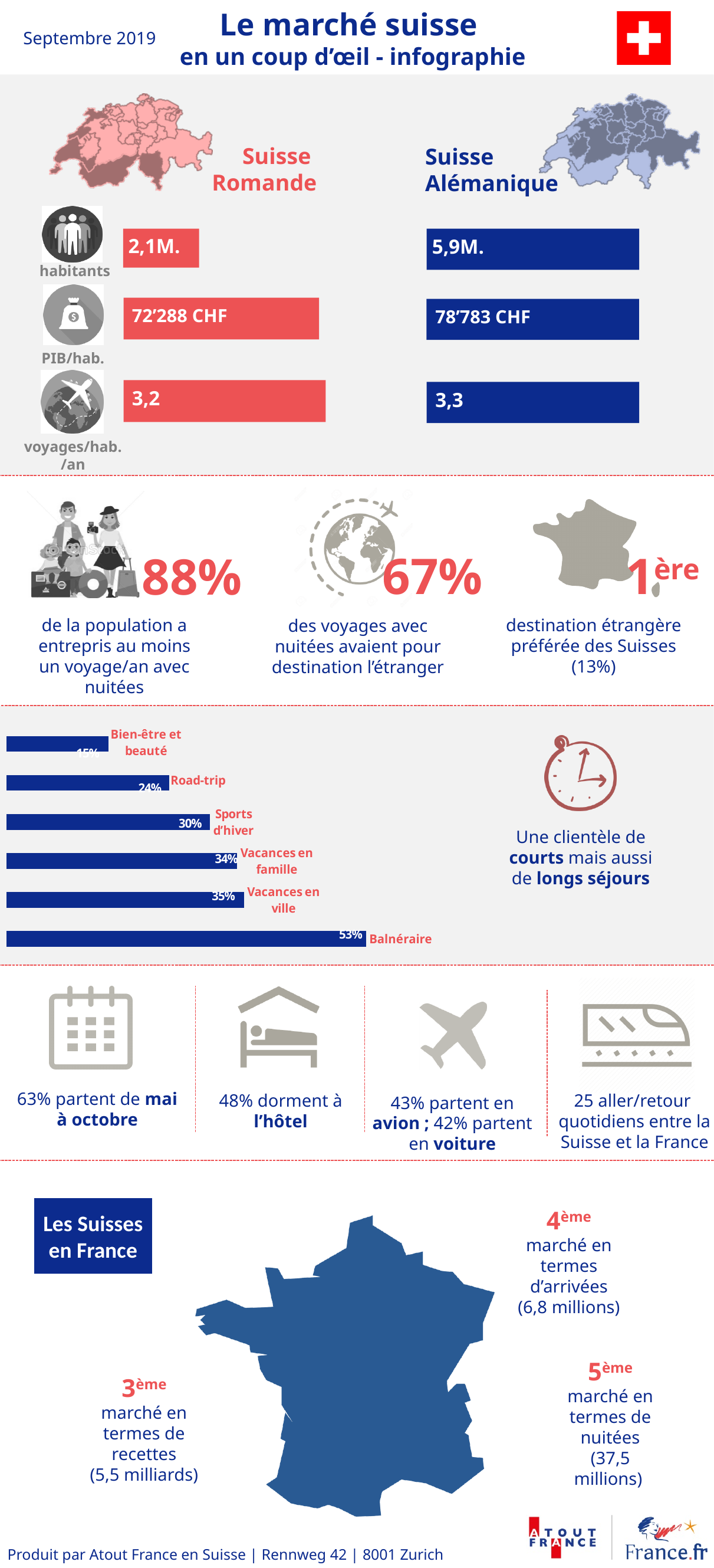
What kind of chart is used to show the holiday types (Bien-être et beauté, Road-trip, etc.)? bar chart In the top comparison bars, how many habitants does Suisse Alémanique have? 5,9M. In the bar chart of holiday types, which category has the highest value? Balnéraire In the bar chart of holiday types, what is the difference between Balnéraire and Vacances en ville? 18% In the bar chart of holiday types, what is the value for Road-trip? 24% In the bar chart of holiday types, which is larger: Sports d'hiver or Road-trip? Sports d'hiver In the bar chart of holiday types, which category has the lowest value? Bien-être et beauté In the top comparison bars, which region has the higher number of voyages/hab./an? Suisse Alémanique How many categories are shown in the bar chart of holiday types? 6 In the bar chart of holiday types, what is the value for Vacances en famille? 34% In the top comparison bars, what is the PIB/hab. for Suisse Romande? 72'288 CHF In the bar chart of holiday types, what is the value for Balnéraire? 53%